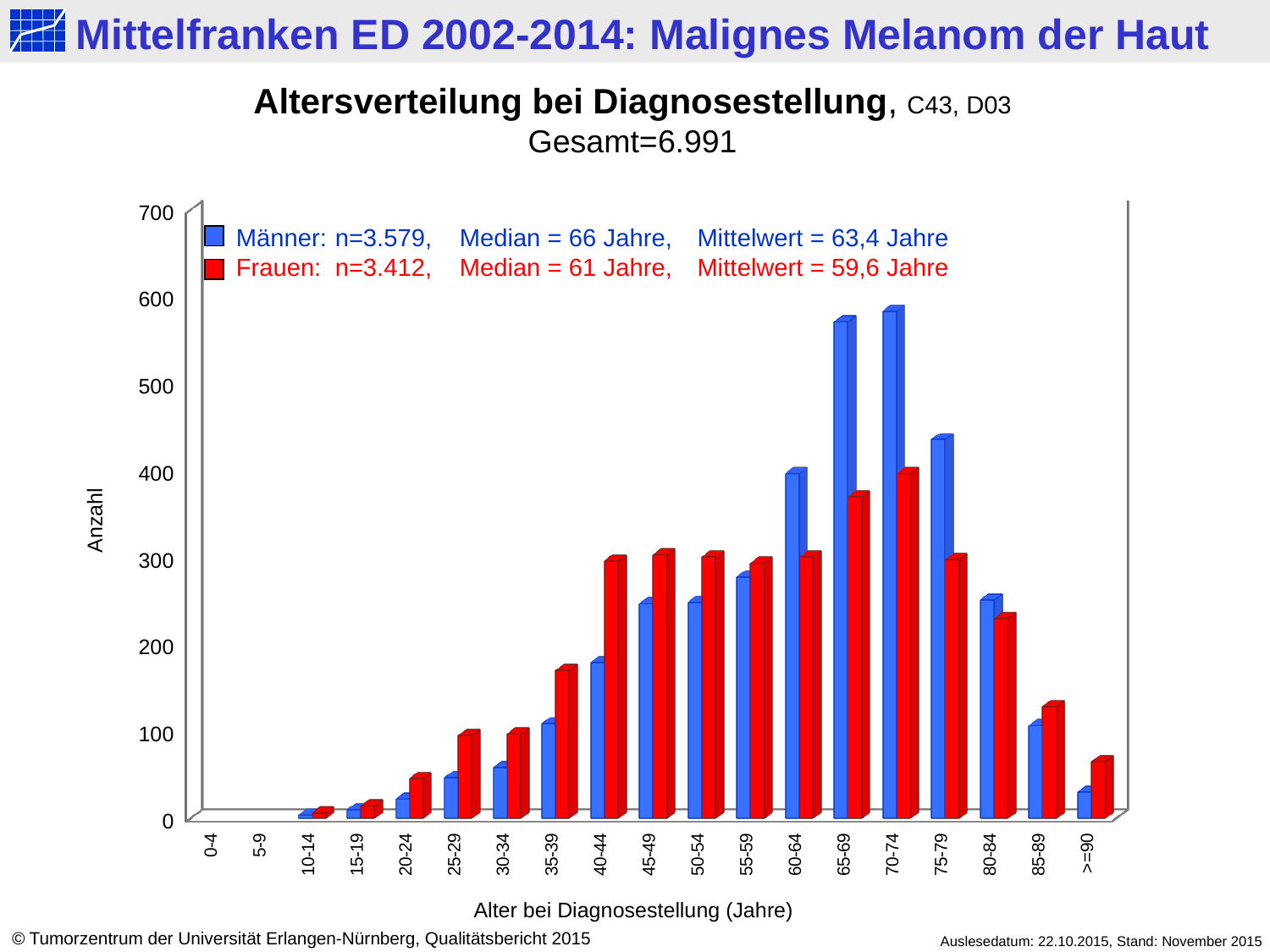
What kind of chart is shown on the slide? bar chart For which age group is the Frauen value highest? 70-74 According to the legend, what is the median age for Frauen? 61 Jahre Is the Männer value for the 60-64 age group greater or less than 300? greater In the 65-69 age group, which series has the larger value, Männer or Frauen? Männer In the 40-44 age group, which series has the larger value, Männer or Frauen? Frauen Is the Frauen value for the 65-69 age group greater or less than 400? less Is the Männer value for the 75-79 age group greater or less than 400? greater How many series does the legend list? 2 How many age categories are shown on the x axis? 19 Do the Männer values rise or fall from the 20-24 age group to the 60-64 age group? rise